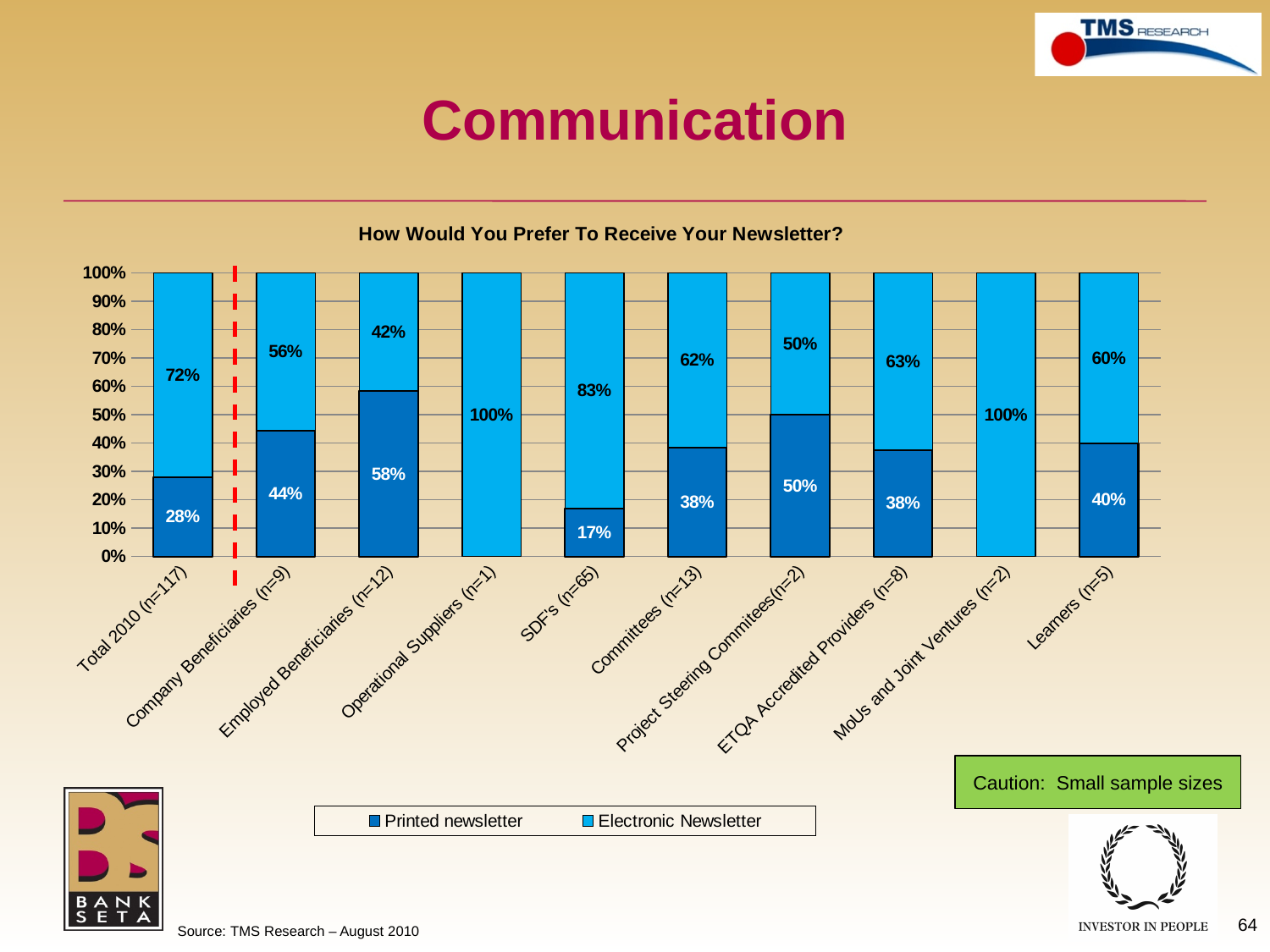
What is the difference between the Electronic Newsletter and Printed newsletter percentages for Committees (n=13)? 24% Among categories with a printed newsletter share shown, which has the lowest Printed newsletter percentage? SDF's (n=65) Which two categories show 100% preference for the Electronic Newsletter? Operational Suppliers (n=1) and MoUs and Joint Ventures (n=2) How many categories are shown on the x axis of the chart? 10 What type of chart is shown on the slide? Stacked bar chart Which is larger for Learners (n=5): the Printed newsletter share or the Electronic Newsletter share? Electronic Newsletter What percentage of Total 2010 (n=117) prefer an electronic newsletter? 72% What is the Electronic Newsletter value for ETQA Accredited Providers (n=8)? 63% What percentage of SDF's (n=65) prefer a printed newsletter? 17% What is the Printed newsletter value for Employed Beneficiaries (n=12)? 58% Which category has the highest Printed newsletter percentage? Employed Beneficiaries (n=12) How many series does the legend list? 2